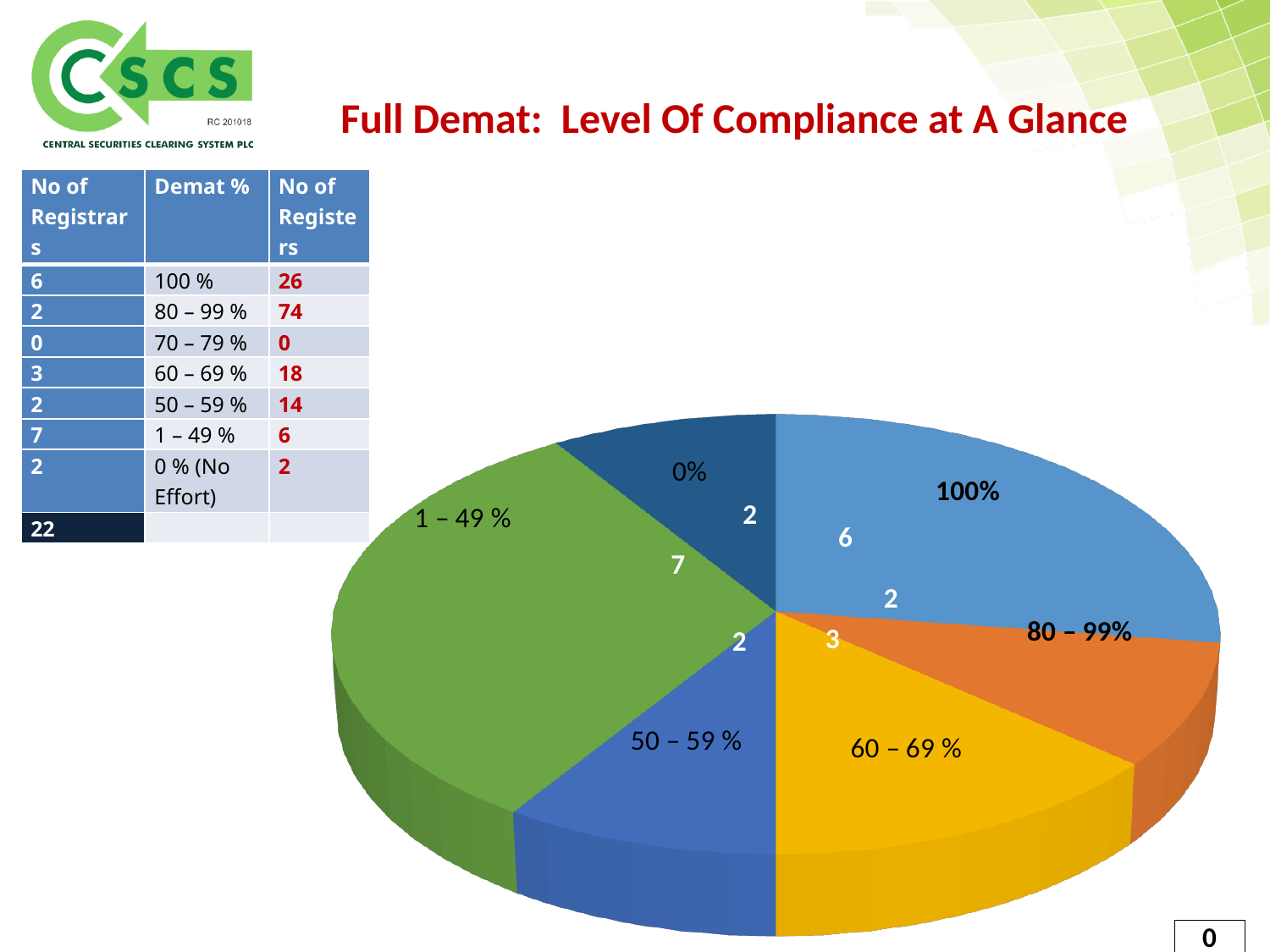
How many registrars are in the 80 – 99% slice of the pie chart? 2 What is the difference in registrars between the 1 – 49 % slice and the 60 – 69 % slice? 4 How many registrars are in the 1 – 49 % slice of the pie chart? 7 How many registrars are in the 100% slice of the pie chart? 6 What is the title of the slide containing the pie chart? Full Demat: Level Of Compliance at A Glance How many registrars are in the 60 – 69 % slice of the pie chart? 3 What is the difference in registrars between the 100% slice and the 50 – 59 % slice? 4 How many slices are visible in the pie chart? 6 Which slice of the pie chart has the largest number of registrars? 1 – 49 % Which has more registrars in the pie chart, the 100% slice or the 1 – 49 % slice? 1 – 49 % What type of chart is shown on the slide? pie chart How many registrars are in the 0% slice of the pie chart? 2